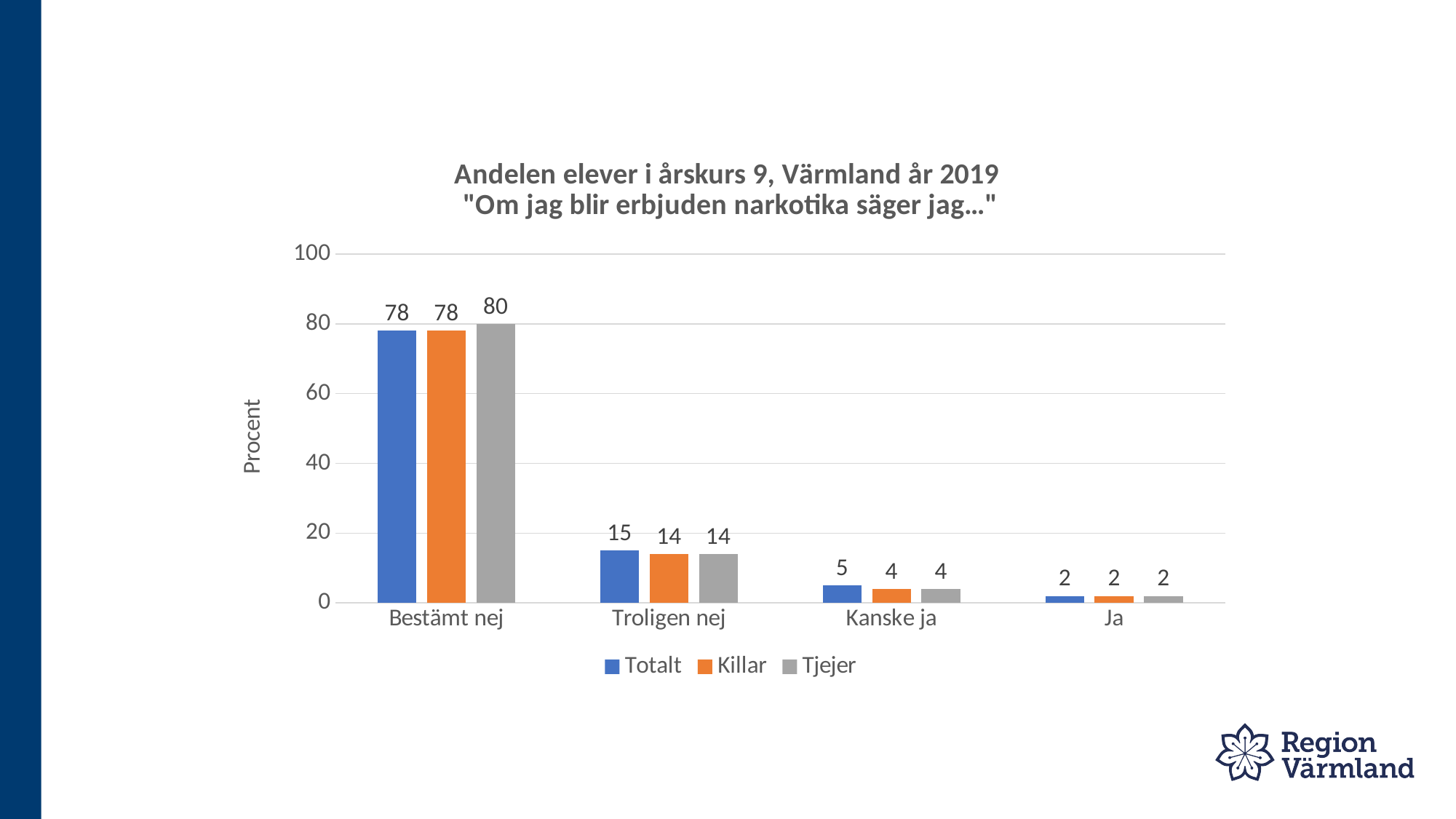
What is the difference between the Tjejer and Killar values in the Bestämt nej category? 2 Which category has the lowest value for Tjejer? Ja Which is larger in the Troligen nej category, the value for Totalt or the value for Killar? Totalt Which category has the highest value for Totalt? Bestämt nej How many categories are shown on the x axis? 4 How many series does the legend list? 3 What is the value for Totalt in the Troligen nej category? 15 What is the value for Tjejer in the Bestämt nej category? 80 What is the value for Killar in the Kanske ja category? 4 Is the value for Totalt in the Bestämt nej category greater or less than 60? greater What kind of chart is shown on the slide? bar chart What is the label of the y axis? Procent